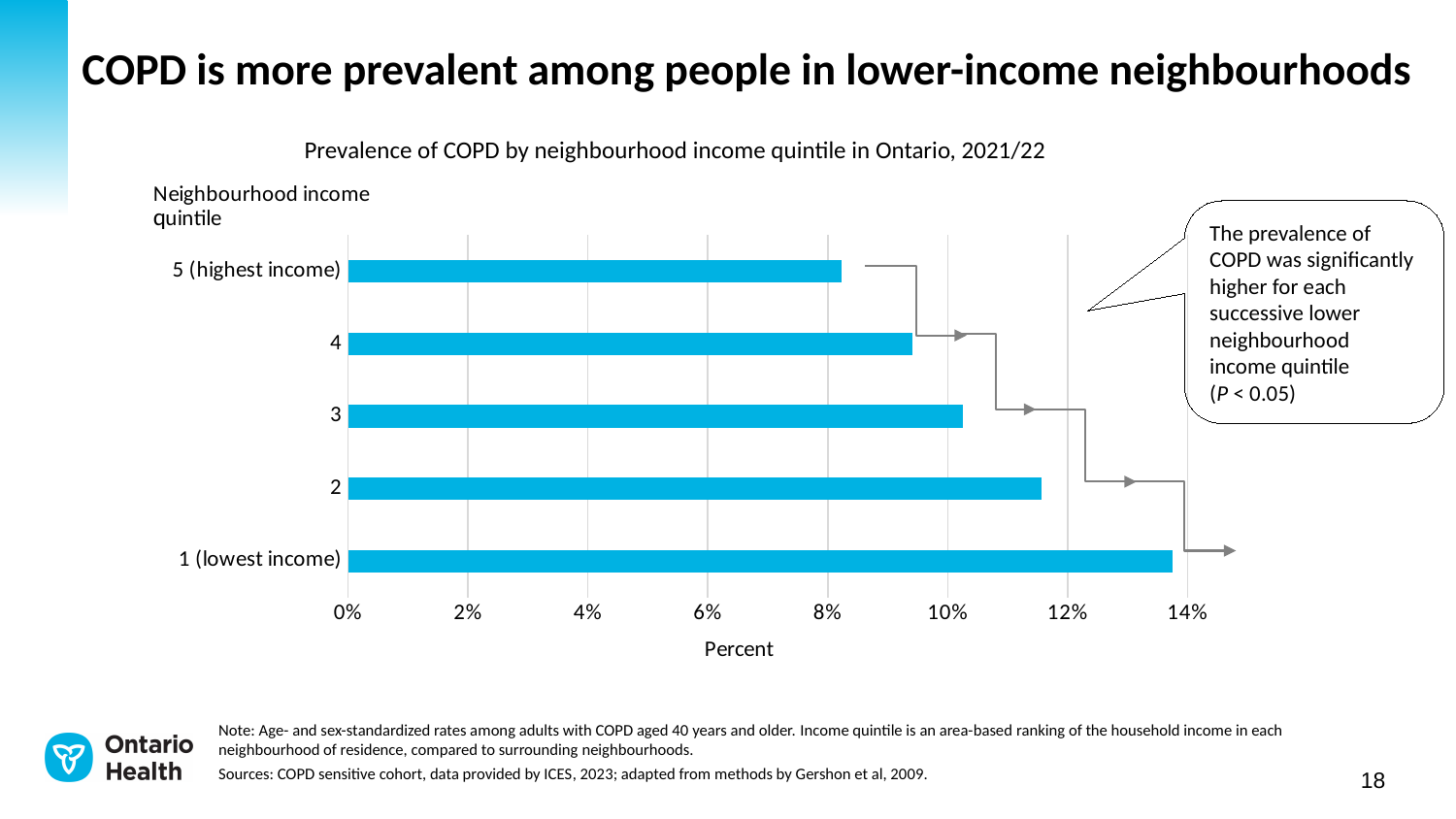
Is the COPD prevalence for quintile 5 (highest income) greater or less than 10%? less Is the COPD prevalence for quintile 4 greater or less than 10%? less Is the COPD prevalence for quintile 3 greater or less than 8%? greater Which neighbourhood income quintile has the highest prevalence of COPD? 1 (lowest income) What kind of chart is shown on the slide? Bar chart Which has a higher COPD prevalence, quintile 2 or quintile 4? Quintile 2 What is the label on the horizontal axis of the chart? Percent How many neighbourhood income quintiles are plotted in the chart? 5 Does COPD prevalence rise or fall as the neighbourhood income quintile goes from 5 (highest income) down to 1 (lowest income)? Rise Which neighbourhood income quintile has the lowest prevalence of COPD? 5 (highest income)